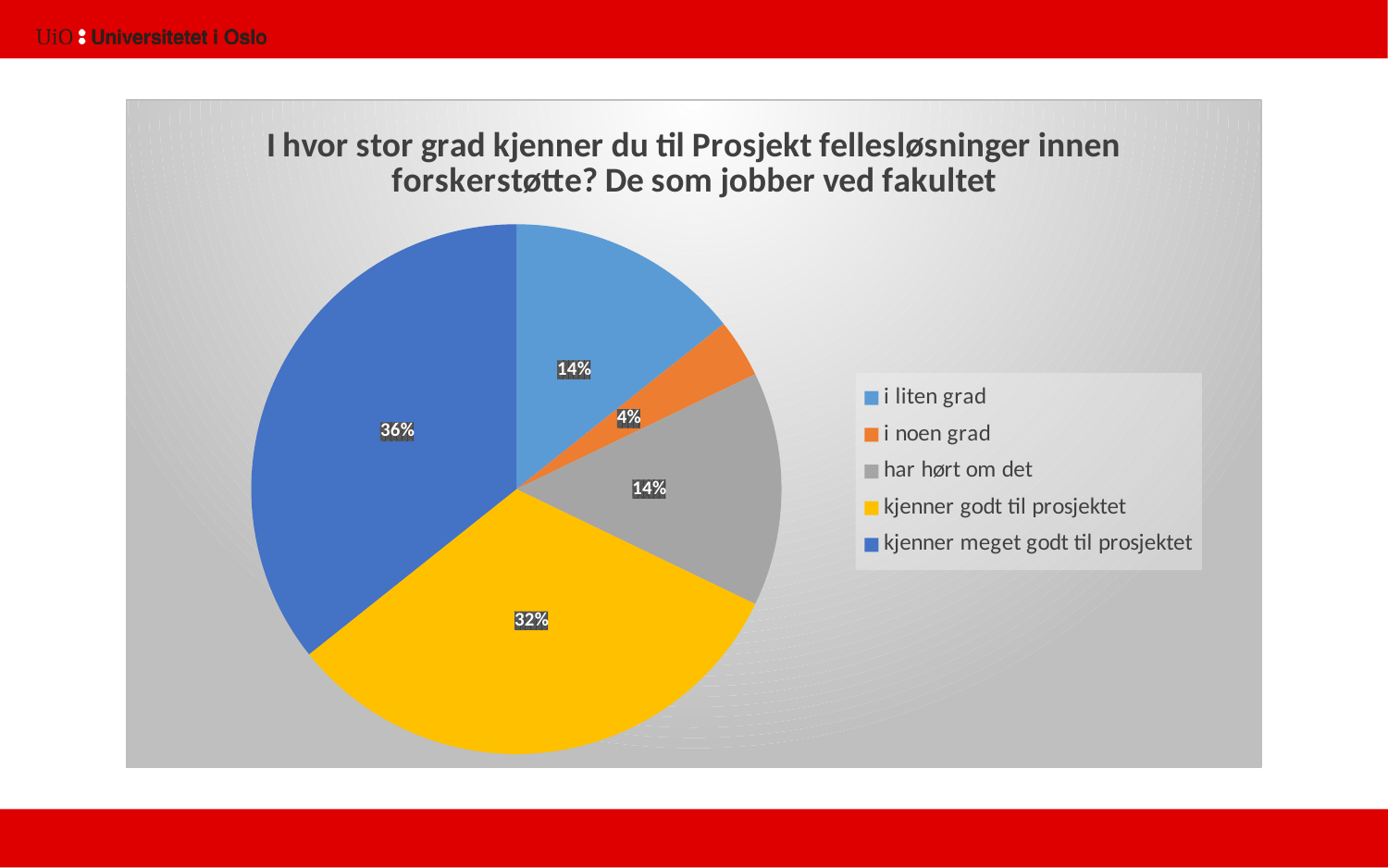
What share of the pie is 'i liten grad'? 14% Which is larger: the share for 'i liten grad' or the share for 'i noen grad'? i liten grad What is the difference between the shares for 'kjenner meget godt til prosjektet' and 'kjenner godt til prosjektet'? 4% How many categories does the legend list? 5 What share of the pie is 'kjenner meget godt til prosjektet'? 36% What share of the pie is 'kjenner godt til prosjektet'? 32% Which category has the largest slice of the pie? kjenner meget godt til prosjektet Which category has the smallest slice of the pie? i noen grad What kind of chart is shown on the slide? pie chart What colour is the slice for 'kjenner godt til prosjektet'? yellow